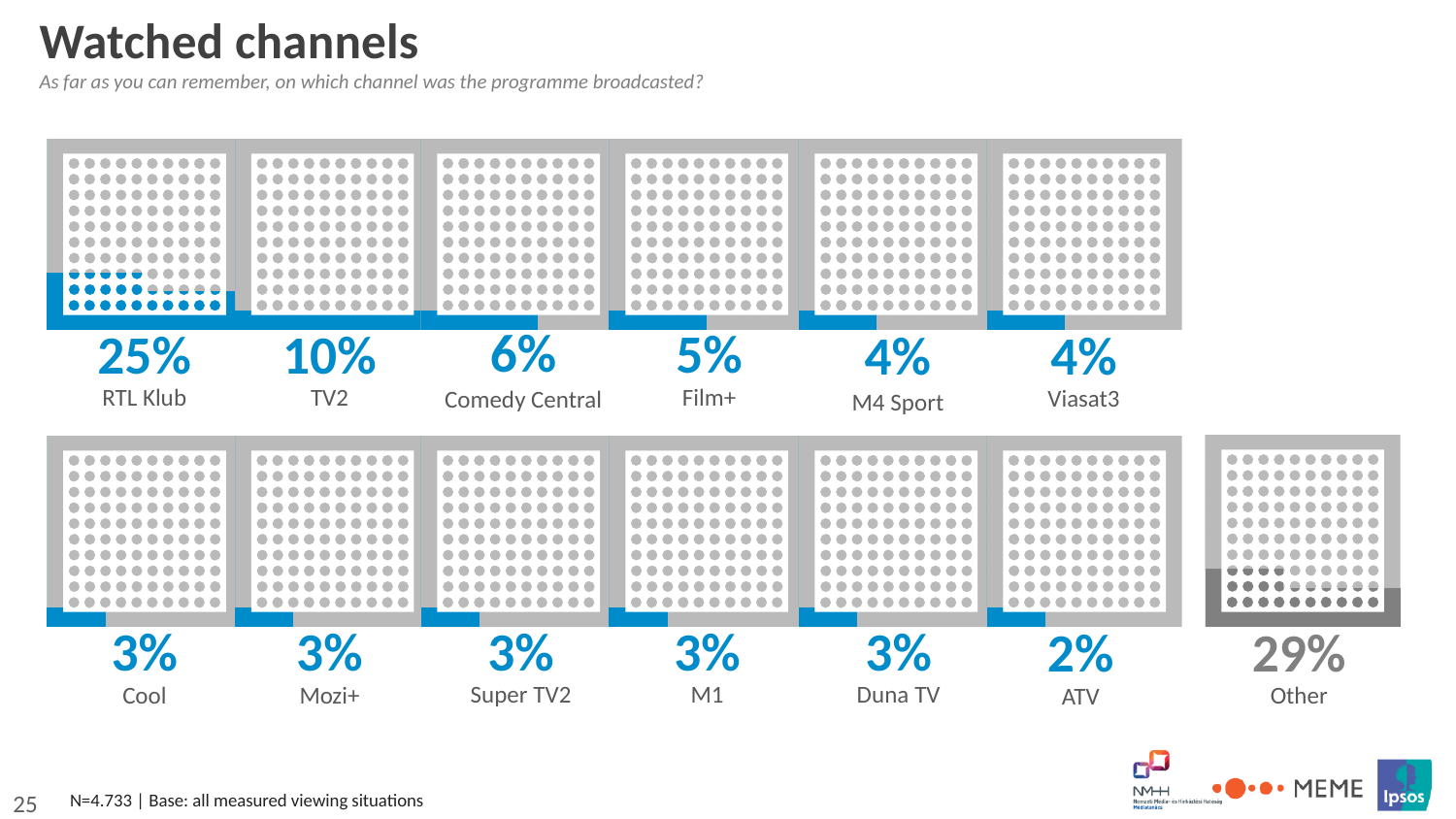
What is the title of the slide's chart? Watched channels How many categories (including Other) are shown on the slide? 13 Which is larger, the share for Film+ or the share for M4 Sport? Film+ Which channel has the lowest share on the slide? ATV What is the value shown for TV2? 10% What is the value for ATV? 2% What is the difference between the shares of RTL Klub and TV2? 15% What percentage is shown for Comedy Central? 6% What kind of chart is used on this slide? Waffle (dot matrix) chart Which named channel (excluding Other) has the highest share? RTL Klub What percentage is shown for the Other category? 29% What percentage of viewing situations was RTL Klub? 25%